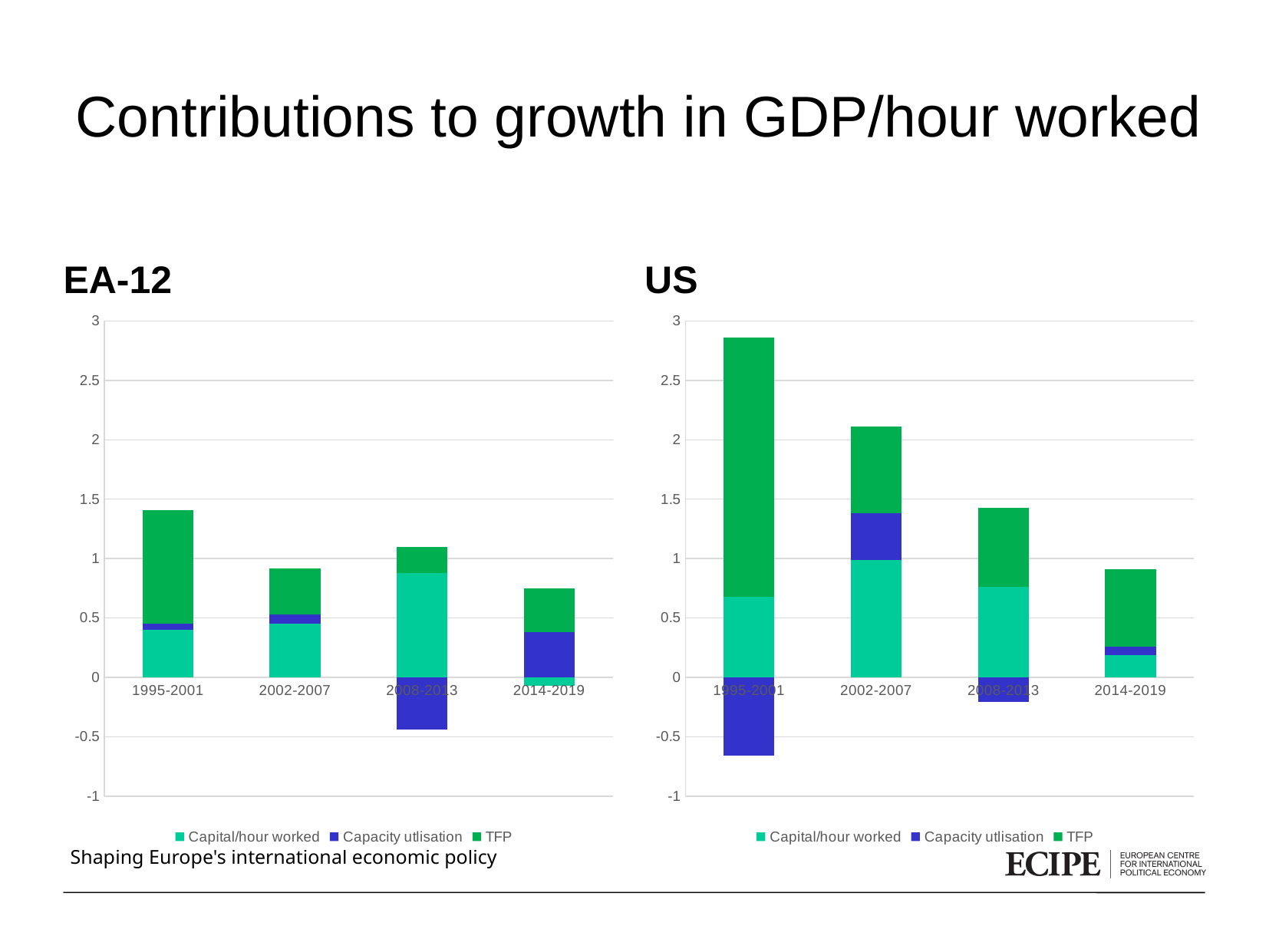
What kind of chart is the EA-12 chart? stacked bar chart In the US chart, which period has the tallest positive stacked bar? 1995-2001 In the EA-12 chart, is the top of the stacked bar for 1995-2001 greater or less than 1? greater In the US chart, which period has a higher top of the stacked bar, 2002-2007 or 2008-2013? 2002-2007 In the EA-12 chart, which period has the tallest positive stacked bar? 1995-2001 In the US chart, is the top of the stacked bar for 2014-2019 greater or less than 1? less In the US chart, which series is shown in dark blue? Capacity utlisation How many series does the legend of the US chart list? 3 How many time periods are shown on the x axis of the EA-12 chart? 4 In the US chart, is the top of the stacked bar for 1995-2001 greater or less than 2.5? greater What are the three series listed in the legend of the EA-12 chart? Capital/hour worked, Capacity utlisation, TFP